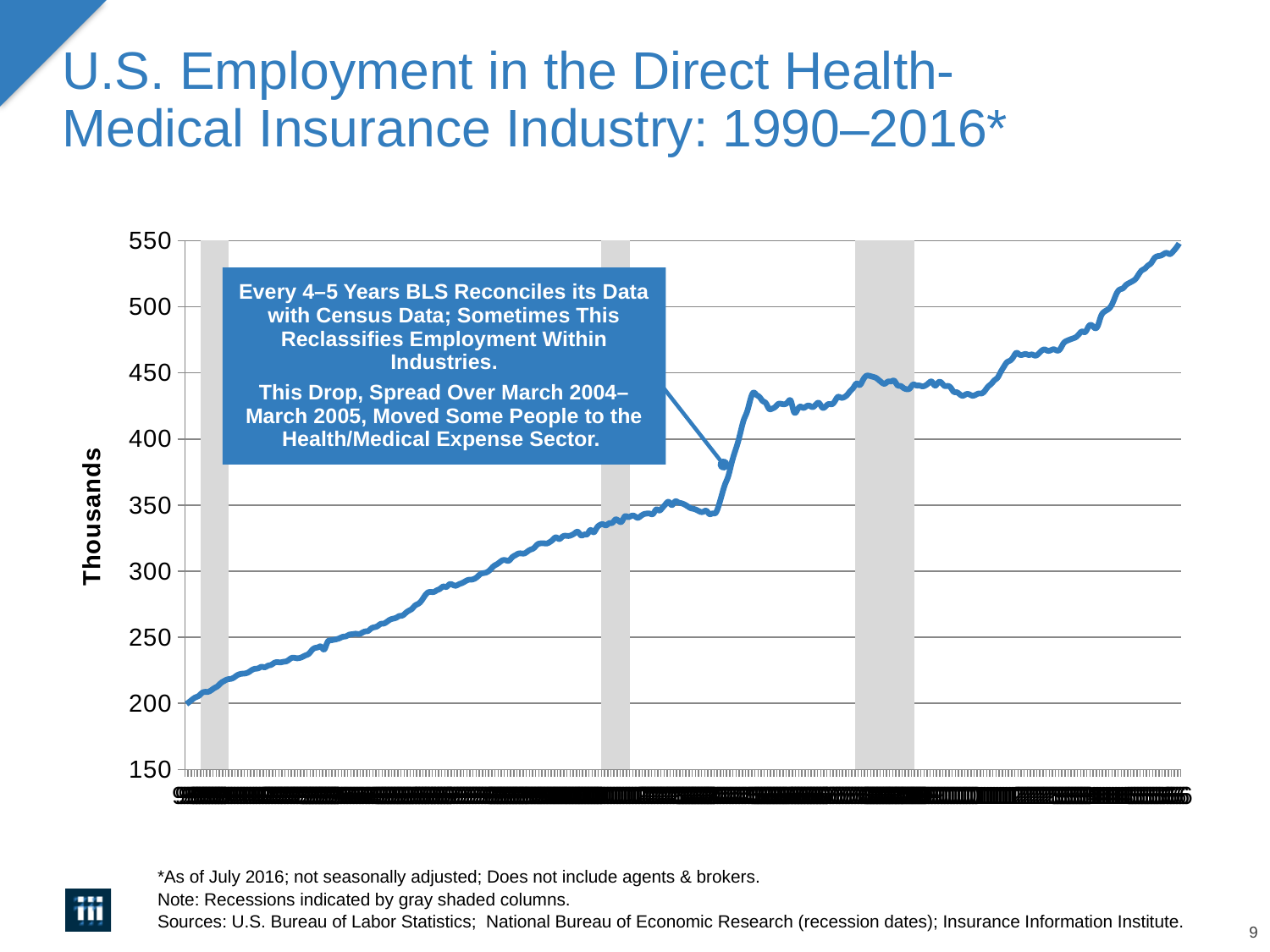
What is the highest value shown on the vertical axis of the chart? 550 What kind of chart is shown on the slide? line chart What is the title of the chart on the slide? U.S. Employment in the Direct Health-Medical Insurance Industry: 1990–2016* Is the value at the right end of the line greater or less than the value at the left end of the line? greater Is the value at the right end of the line (the most recent point) greater or less than 500? greater What is the label on the vertical axis of the chart? Thousands Is the value at the left end of the line (the earliest point) greater or less than 250? less Is the value at the peak of the line just before the March 2004–March 2005 drop greater or less than 400? less Overall, do the values rise or fall from the left end of the chart to the right end? rise